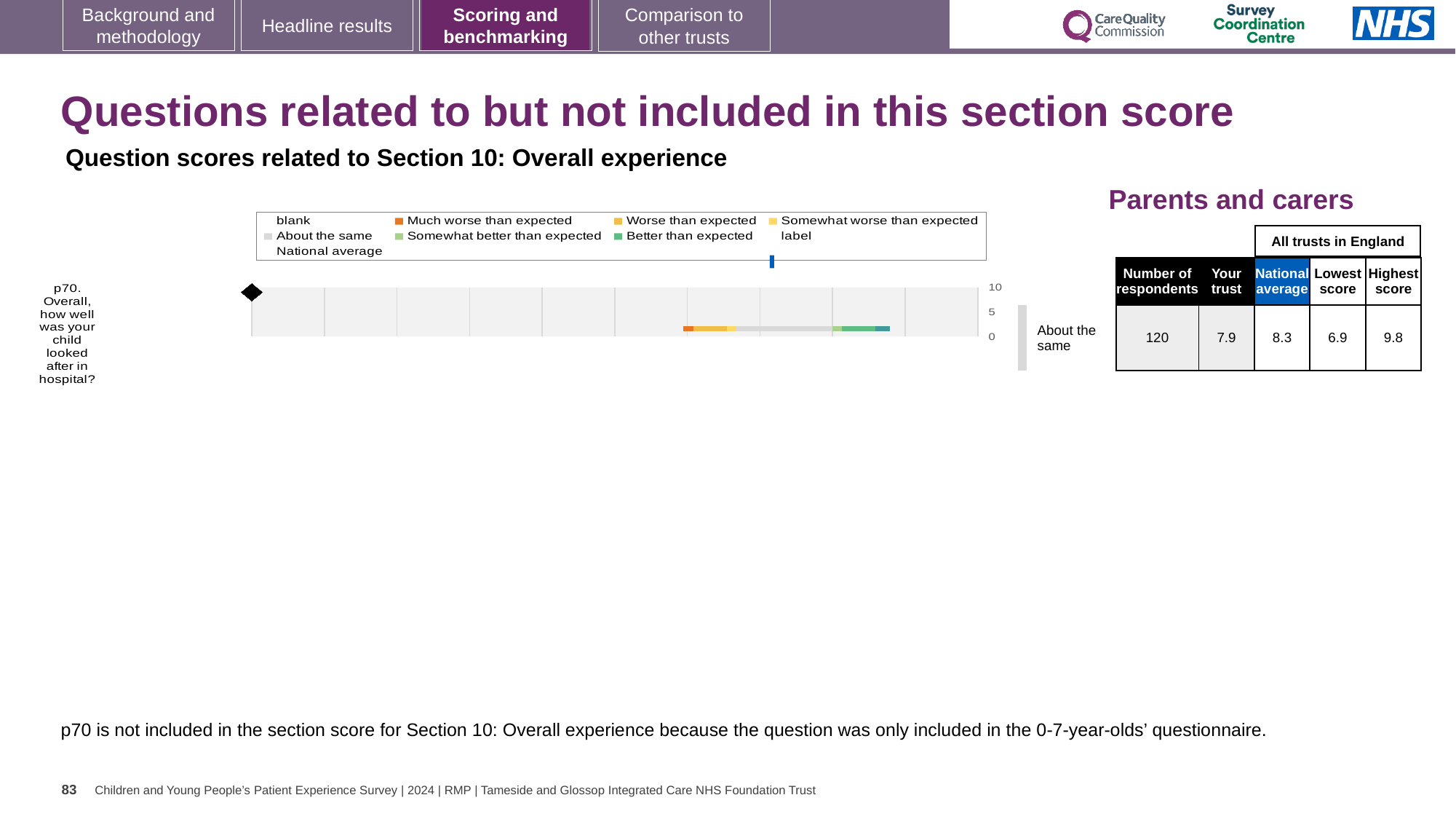
Is the trust's score for p70 greater or less than 5 on the chart's axis? greater What kind of chart is used to show the p70 question score? bar chart What is the national average score for p70? 8.3 What is the difference between the highest and lowest trust scores for p70? 2.9 What is the 'Your trust' score for p70? 7.9 How many questions are plotted in the chart? 1 Which question is plotted in the chart? p70. Overall, how well was your child looked after in hospital? Which benchmark category does the trust's result for p70 fall into? About the same What is the highest score among all trusts in England for p70? 9.8 Which is larger for p70, the trust's score or the national average? National average How many respondents answered p70? 120 What is the difference between the national average and the trust's score for p70? 0.4